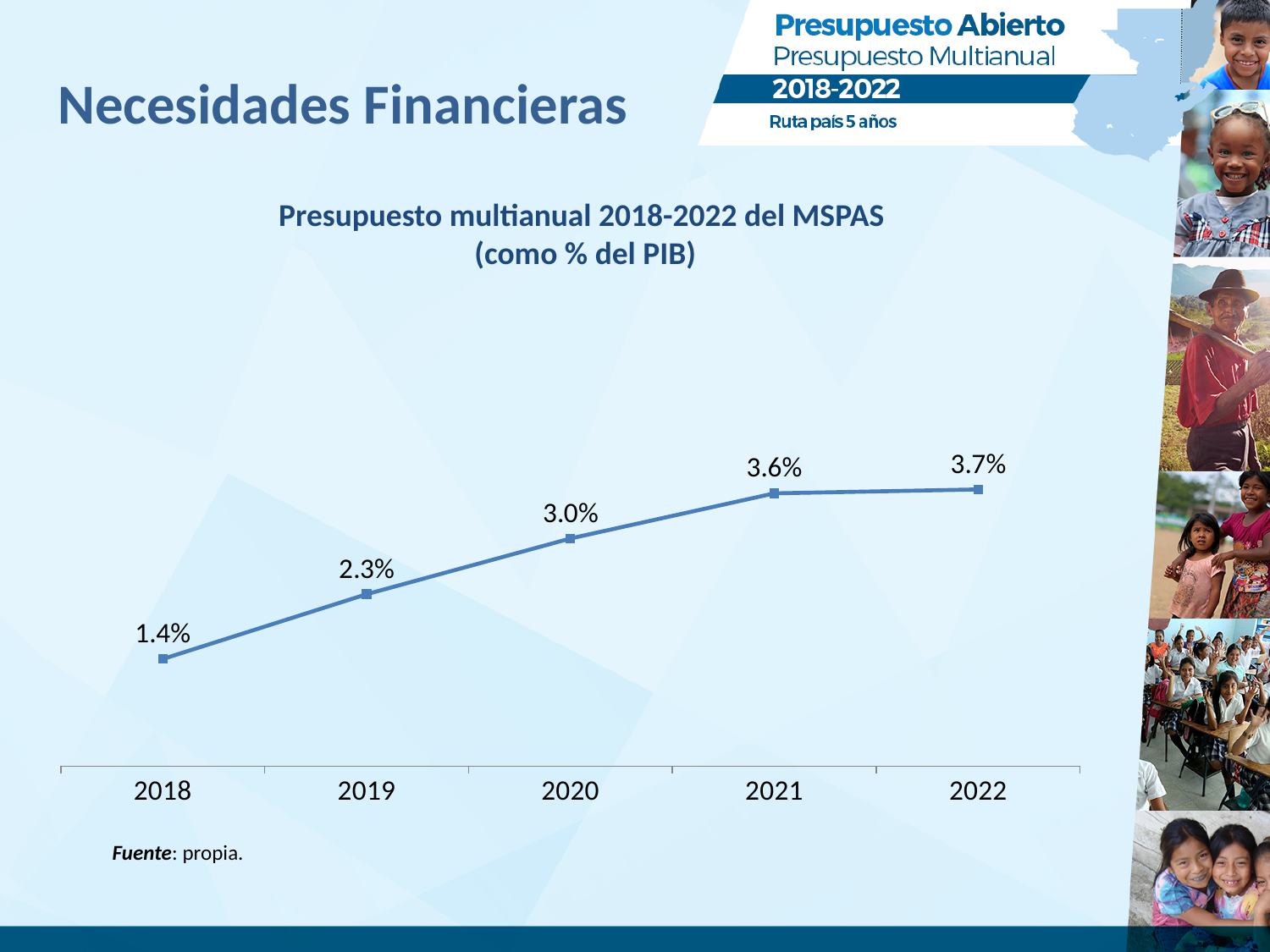
What is the value for 2020? 3.0% What is the difference between the values for 2021 and 2019? 1.3% What is the title of the chart? Presupuesto multianual 2018-2022 del MSPAS (como % del PIB) How many years are plotted on the chart? 5 Which year has the lowest value? 2018 Do the values rise or fall from 2018 to 2022? rise What is the difference between the values for 2022 and 2018? 2.3% What is the value for 2018? 1.4% Which is larger, the value for 2019 or the value for 2020? 2020 Which year has the highest value? 2022 What is the value for 2022? 3.7% What kind of chart is shown? line chart